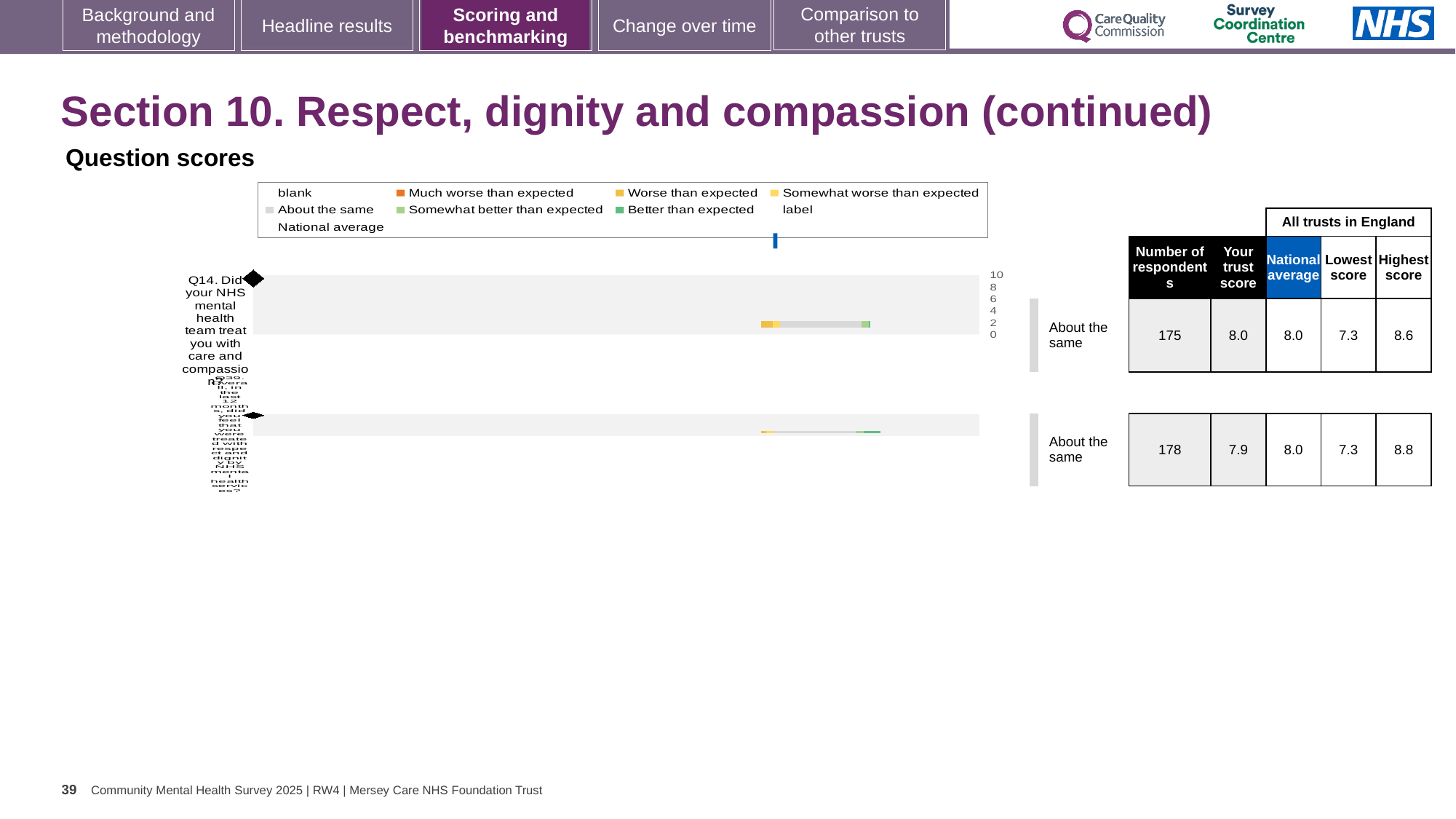
According to the table beside the chart, what is the difference between the highest score and the lowest score for Q14? 1.3 What is the highest tick value shown on the chart's axis? 10 According to the table beside the chart, what is the trust score for Q39? 7.9 What benchmark category is shown next to the bar for Q14? About the same Which legend entry is shown with an orange marker? Much worse than expected According to the table beside the chart, how many respondents answered Q39? 178 How many questions (categories) are plotted in the chart? 2 According to the table beside the chart, what is the trust score for Q14? 8.0 What kind of chart is shown under 'Question scores'? bar chart What benchmark category is shown next to the bar for Q39? About the same According to the table beside the chart, which question has the higher highest score across all trusts in England, Q14 or Q39? Q39 According to the table beside the chart, what is the national average for Q14? 8.0